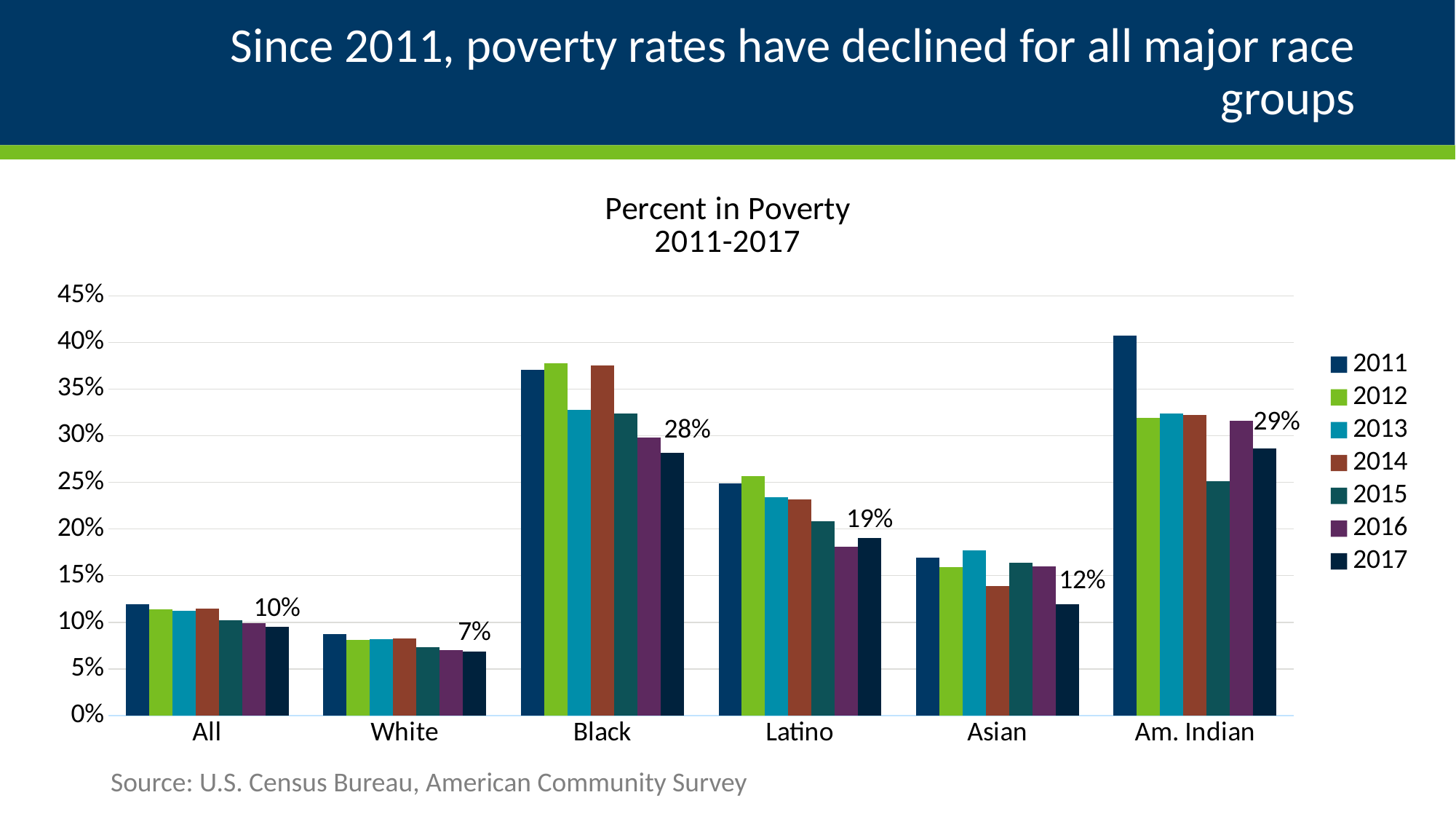
Is the 2015 value for the Am. Indian group greater or less than 30%? less What is the 2017 poverty rate for the Latino group? 19% What is the 2017 poverty rate for the Black group? 28% How many race groups are shown on the x axis? 6 What is the difference between the 2017 poverty rates for the Black and Latino groups? 9 percentage points Which group has the lowest 2017 poverty rate? White How many years does the legend list? 7 Is the 2011 value for the Black group greater or less than 35%? greater Which is larger, the 2017 poverty rate for Asian or for All? Asian What is the 2017 poverty rate for the Am. Indian group? 29% What kind of chart is shown on the slide? Bar chart What is the 2017 poverty rate for the White group? 7%